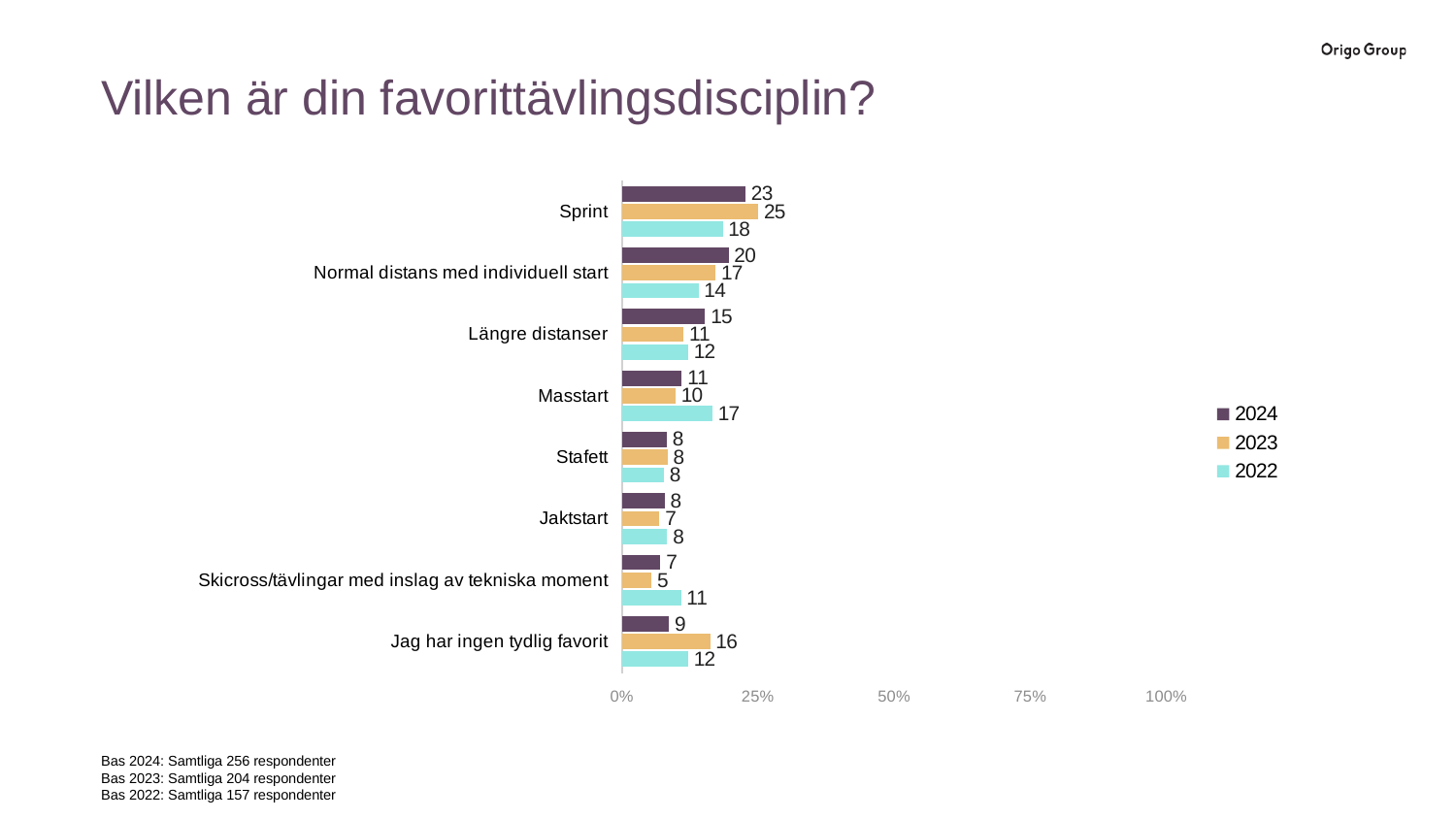
Which is larger for Masstart: the 2024 value or the 2022 value? 2022 What is the value for Sprint in the 2023 series? 25 How many categories are shown on the chart? 8 Which category has the highest value in the 2024 series? Sprint What kind of chart is shown on the slide? Bar chart What is the title of the chart? Vilken är din favorittävlingsdisciplin? How many series does the legend list? 3 What is the value for Masstart in the 2022 series? 17 Which category has the lowest value in the 2023 series? Skicross/tävlingar med inslag av tekniska moment What is the difference between the 2023 and 2024 values for Jag har ingen tydlig favorit? 7 What is the value for Jag har ingen tydlig favorit in the 2024 series? 9